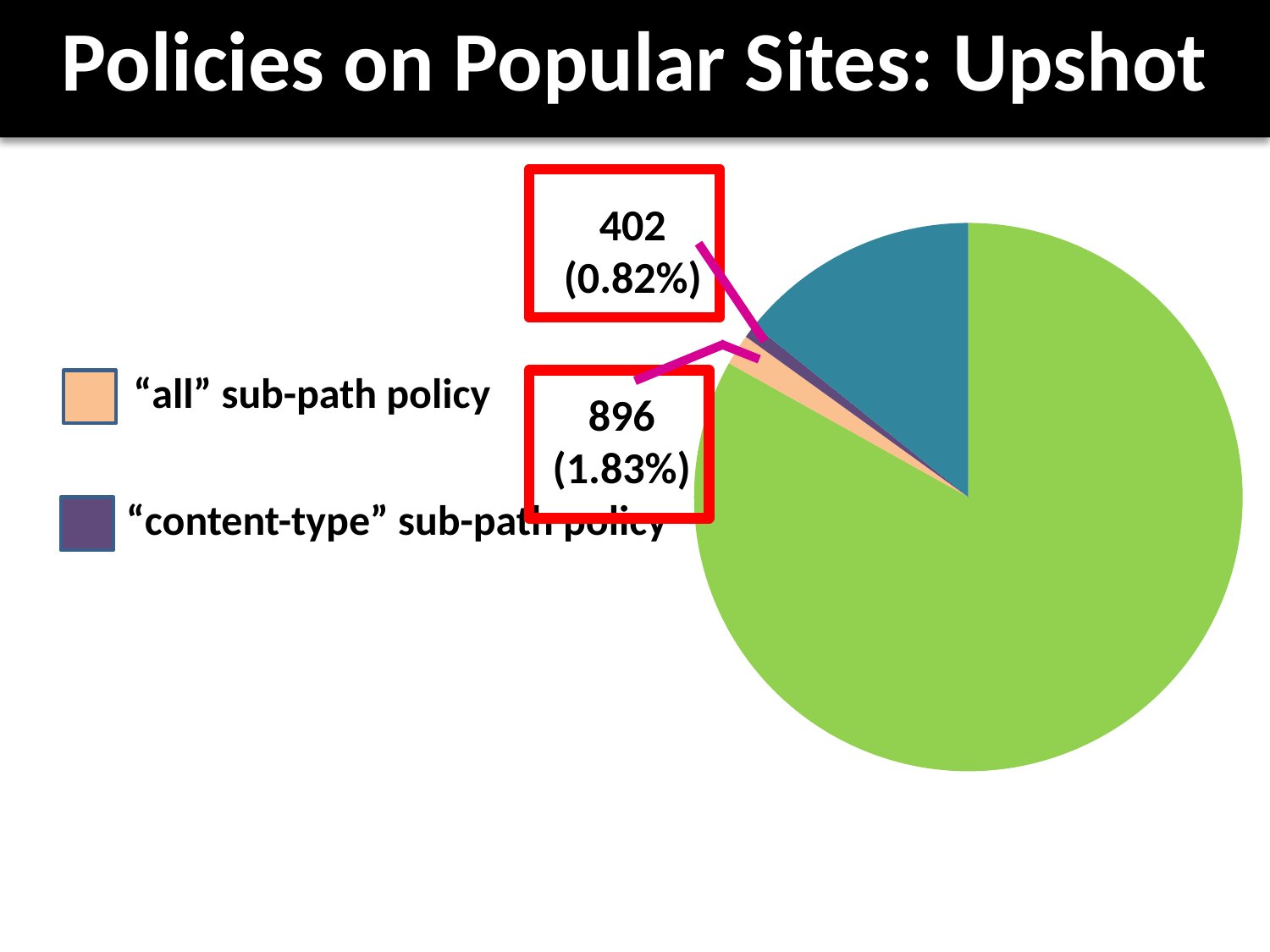
Which is larger, the "all" sub-path policy slice or the "content-type" sub-path policy slice? "all" sub-path policy How many slices does the pie chart have? 4 How many entries does the legend list? 2 What is the count shown for the "content-type" sub-path policy slice? 402 What is the count shown for the "all" sub-path policy slice? 896 What is the title of the slide containing the chart? Policies on Popular Sites: Upshot Of the two categories listed in the legend, which has the smaller share of the pie? "content-type" sub-path policy What share of the pie does the "all" sub-path policy slice represent? 1.83% What kind of chart is shown on the slide? pie chart What share of the pie does the "content-type" sub-path policy slice represent? 0.82% What is the difference between the counts for the "all" sub-path policy and the "content-type" sub-path policy? 494 What colour is the "content-type" sub-path policy slice in the legend? purple